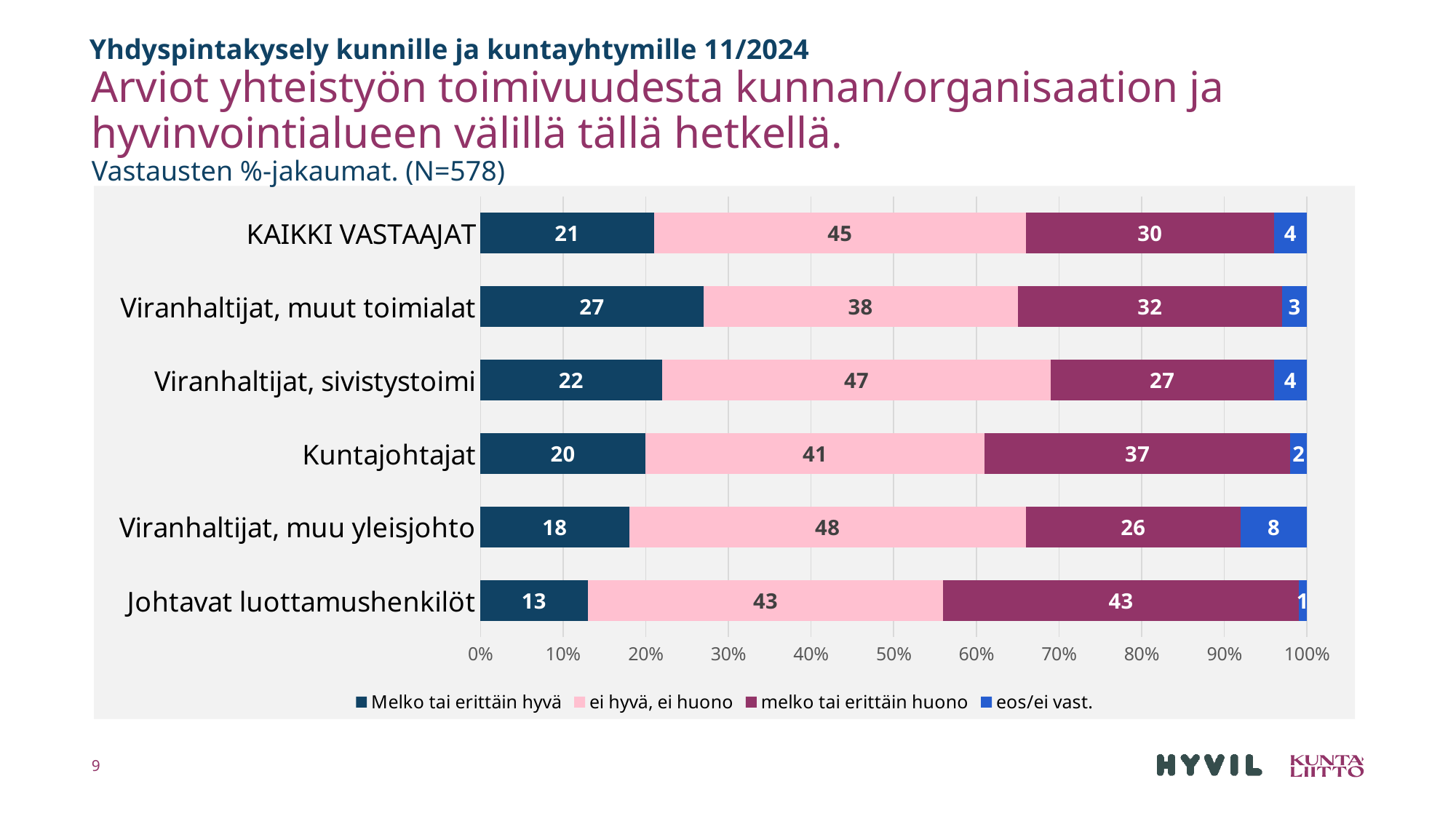
What kind of chart is shown on the slide? Stacked bar chart What is the value of "Melko tai erittäin hyvä" for Kuntajohtajat? 20 How many series does the legend list? 4 What is the total of the stacked bar for Viranhaltijat, sivistystoimi? 100 How many categories are shown on the chart? 6 What is the value of "melko tai erittäin huono" for Johtavat luottamushenkilöt? 43 What is the difference between the "ei hyvä, ei huono" values for Viranhaltijat, muu yleisjohto and Viranhaltijat, muut toimialat? 10 Which category has the highest value for "Melko tai erittäin hyvä"? Viranhaltijat, muut toimialat Which category has the lowest value for "Melko tai erittäin hyvä"? Johtavat luottamushenkilöt Which is larger: the "melko tai erittäin huono" value for Kuntajohtajat or for KAIKKI VASTAAJAT? Kuntajohtajat What is the value of "eos/ei vast." for Viranhaltijat, muu yleisjohto? 8 What is the sample size (N) stated in the chart subtitle? N=578